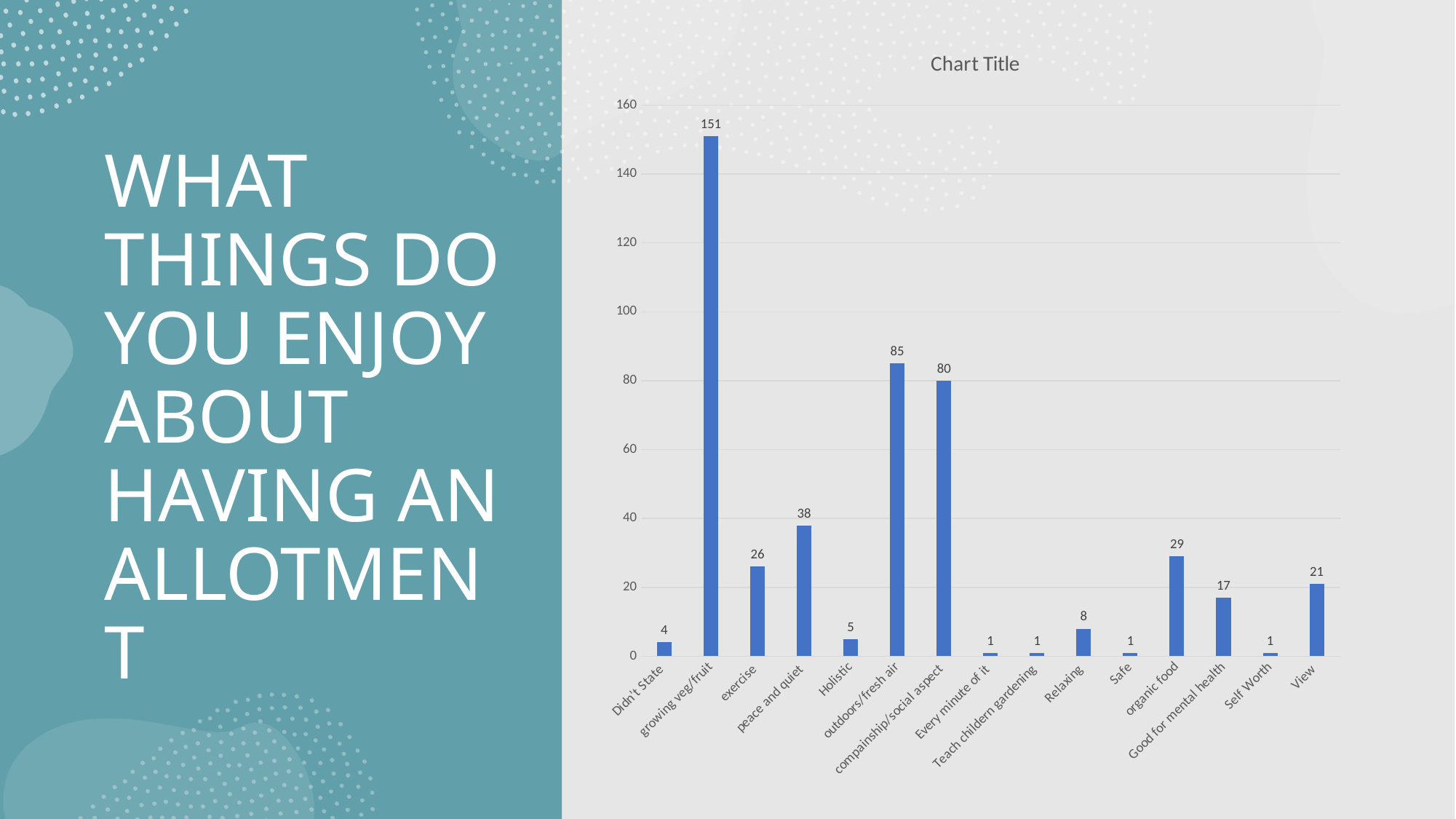
What is the value for outdoors/fresh air? 85 What is the value for peace and quiet? 38 What is the difference between the values for organic food and exercise? 3 Which is larger, the value for View or the value for Good for mental health? View What is the title shown above the chart? Chart Title What kind of chart is shown on the slide? bar chart Which category has the highest value? growing veg/fruit What is the value for Good for mental health? 17 What is the value for growing veg/fruit? 151 Is the value for growing veg/fruit greater or less than 140? greater What is the difference between the values for outdoors/fresh air and compainship/social aspect? 5 How many categories are shown on the x axis? 15